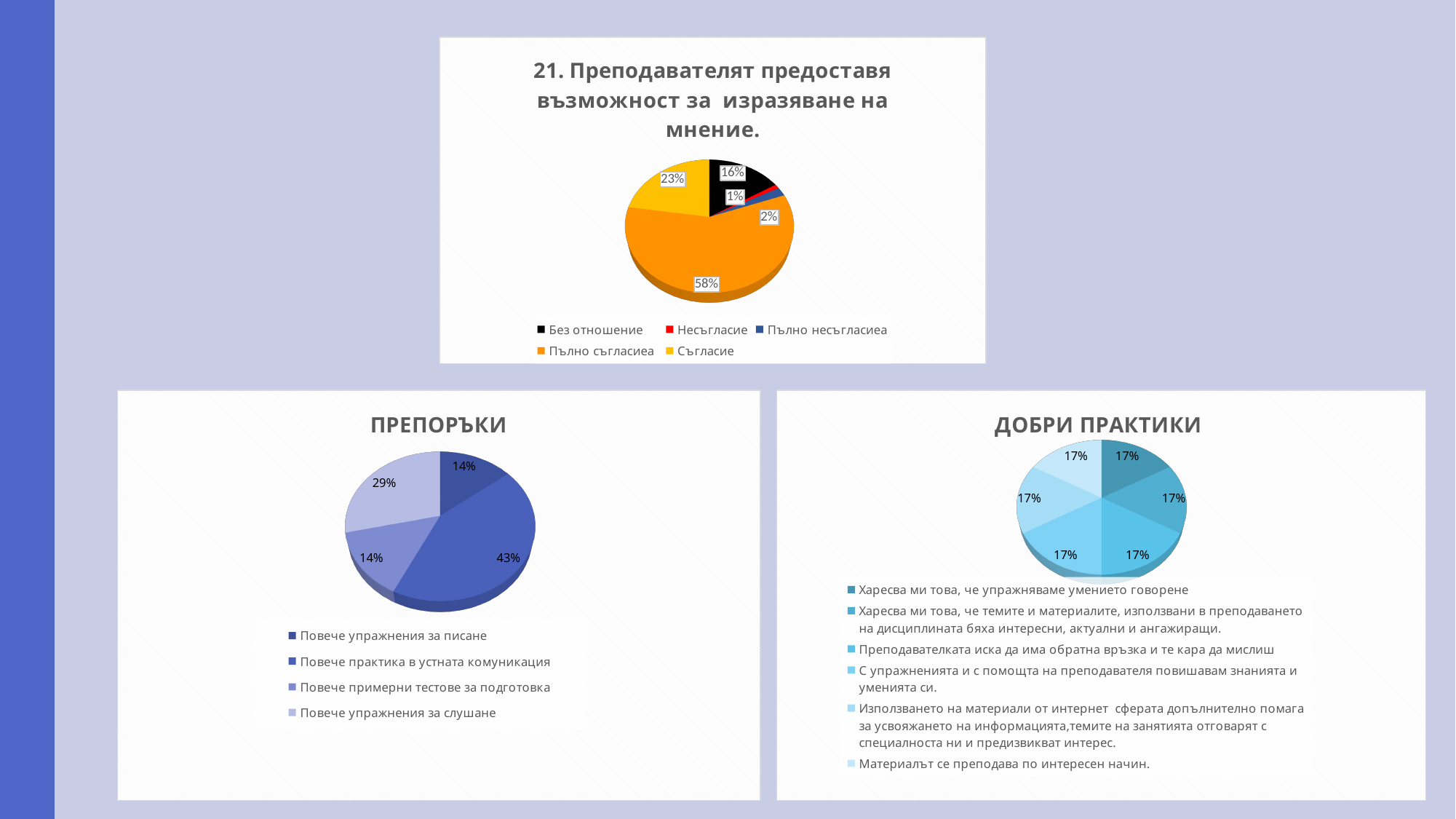
In the chart titled "ПРЕПОРЪКИ", which is larger: the share for "Повече упражнения за слушане" or for "Повече упражнения за писане"? Повече упражнения за слушане In the chart titled "21. Преподавателят предоставя възможност за изразяване на мнение.", what is the difference between the shares of "Пълно съгласиеа" and "Съгласие"? 35% In the chart titled "21. Преподавателят предоставя възможност за изразяване на мнение.", which category has the smallest share? Несъгласие In the chart titled "21. Преподавателят предоставя възможност за изразяване на мнение.", what share does "Съгласие" have? 23% In the chart titled "ДОБРИ ПРАКТИКИ", how many slices does the pie have? 6 In the chart titled "21. Преподавателят предоставя възможност за изразяване на мнение.", how many categories does the legend list? 5 In the chart titled "ПРЕПОРЪКИ", which category has the largest share? Повече практика в устната комуникация In the chart titled "21. Преподавателят предоставя възможност за изразяване на мнение.", which category has the largest share? Пълно съгласиеа What type of chart is the chart titled "ДОБРИ ПРАКТИКИ"? Pie chart In the chart titled "21. Преподавателят предоставя възможност за изразяване на мнение.", what share does "Пълно съгласиеа" have? 58% In the chart titled "ПРЕПОРЪКИ", what share does "Повече практика в устната комуникация" have? 43%